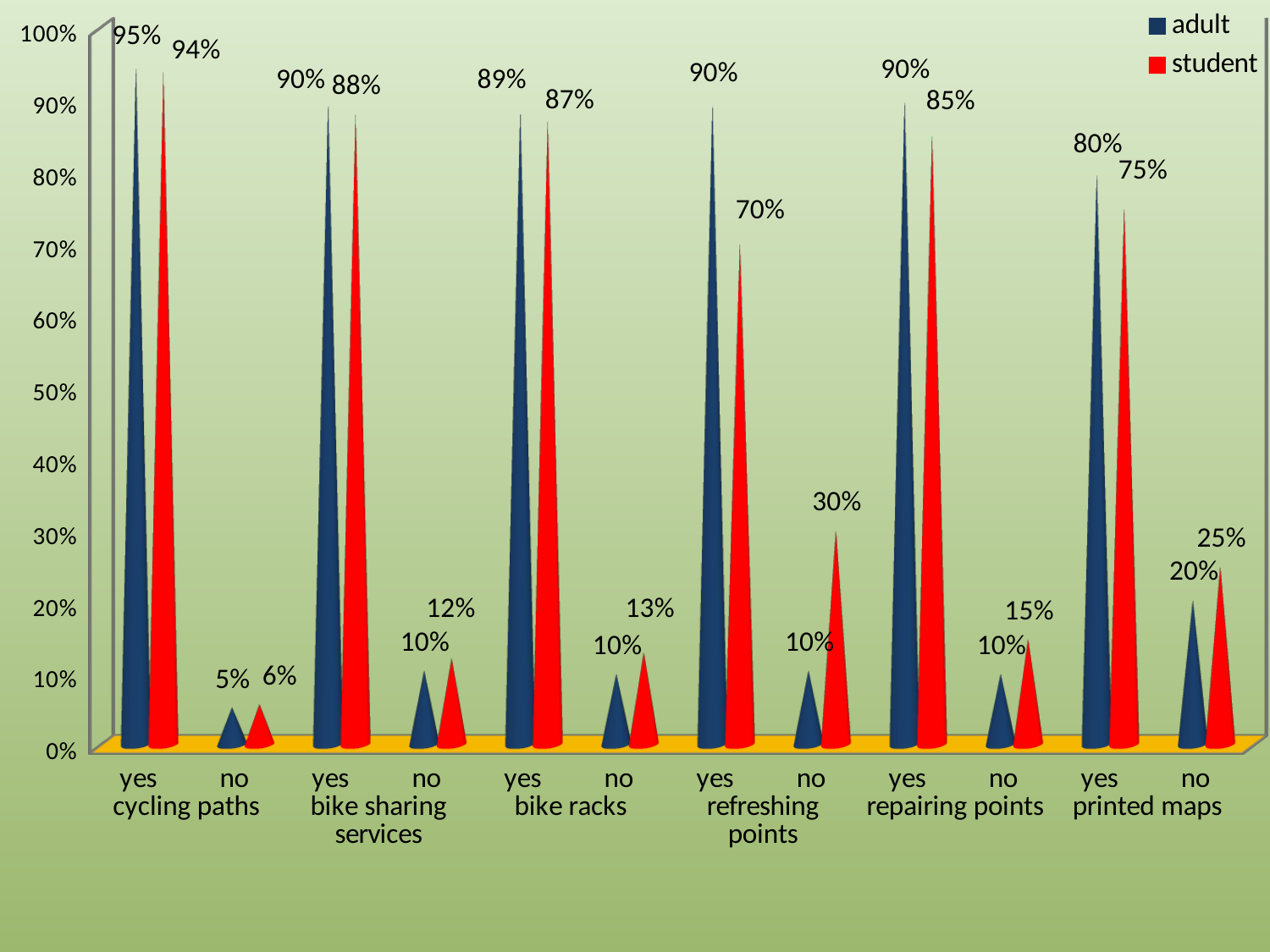
What kind of chart is this? bar chart What is the adult value for 'no' under printed maps? 20% What is the difference between the adult and student values for 'yes' under refreshing points? 20% Which category has the lowest student value? no, cycling paths What is the student value for 'no' under refreshing points? 30% Which is larger for 'no' under bike racks, the adult value or the student value? student Which colour represents the student series? red How many categories are shown along the x axis? 12 What is the student value for 'yes' under printed maps? 75% Which category has the highest adult value? yes, cycling paths What is the adult value for 'yes' under cycling paths? 95% How many series does the legend list? 2